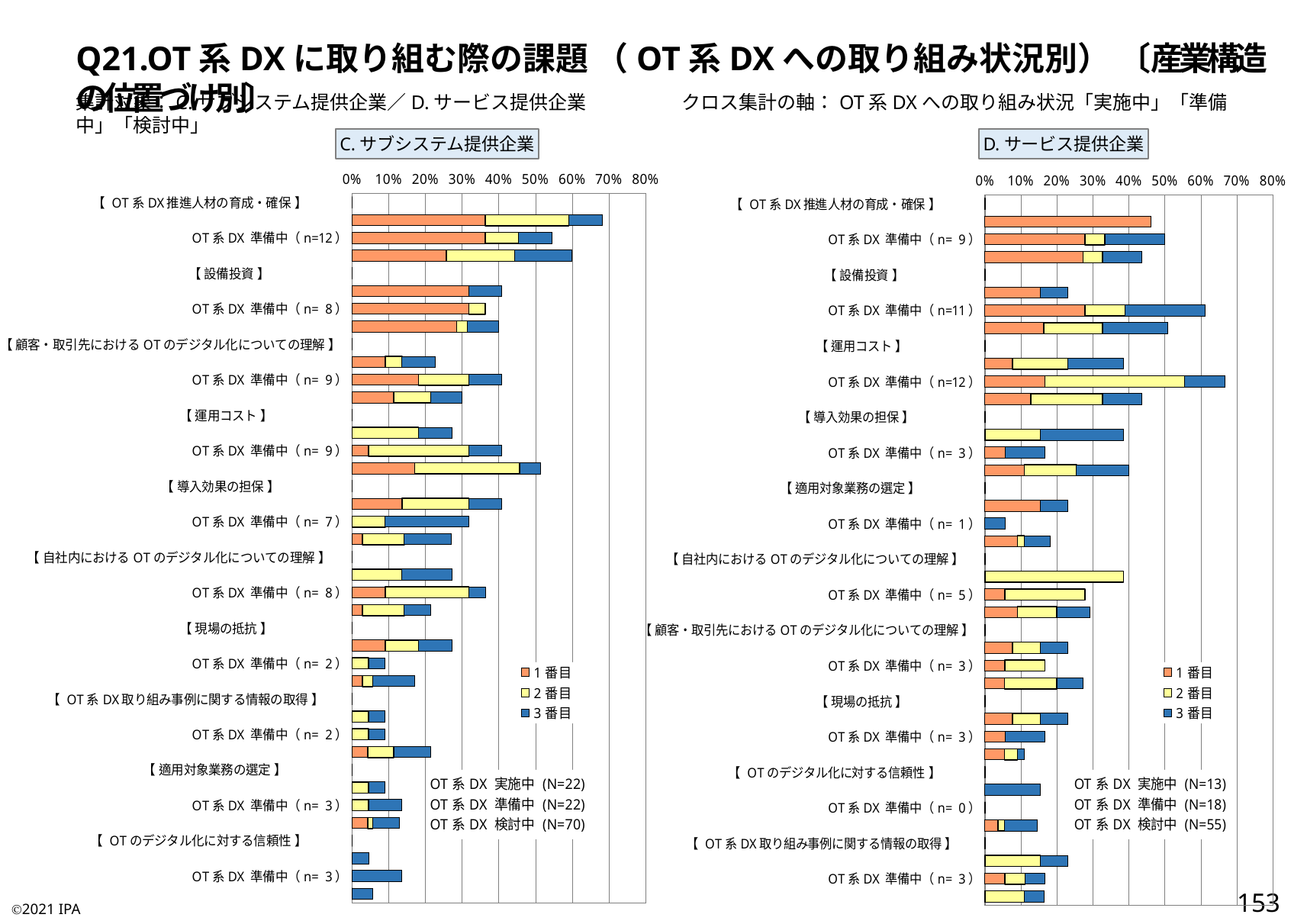
In the C. サブシステム提供企業 chart, is the total bar for OT系DX 実施中 under 【OTのデジタル化に対する信頼性】 greater or less than 10%? less In the D. サービス提供企業 chart, is the total bar for OT系DX 実施中 under 【OT系DX推進人材の育成・確保】 greater or less than 40%? greater In the C. サブシステム提供企業 chart, which challenge category has the longest total bar for OT系DX 実施中? OT系DX推進人材の育成・確保 How many series does the legend list in the D. サービス提供企業 chart? 3 What is the N for OT系DX 実施中 shown in the D. サービス提供企業 chart? N=13 In the C. サブシステム提供企業 chart, is the total bar for OT系DX 実施中 under 【OT系DX推進人材の育成・確保】 greater or less than 60%? greater In the D. サービス提供企業 chart, which challenge category has the longest total bar for OT系DX 準備中? 運用コスト What kind of chart is used for C. サブシステム提供企業? Stacked bar chart What are the legend entries in the C. サブシステム提供企業 chart? 1番目, 2番目, 3番目 In the C. サブシステム提供企業 chart, how many challenge categories (bracketed headings) are listed? 10 In the C. サブシステム提供企業 chart, which is larger for OT系DX 実施中: the total bar under 【OT系DX推進人材の育成・確保】 or under 【設備投資】? OT系DX推進人材の育成・確保